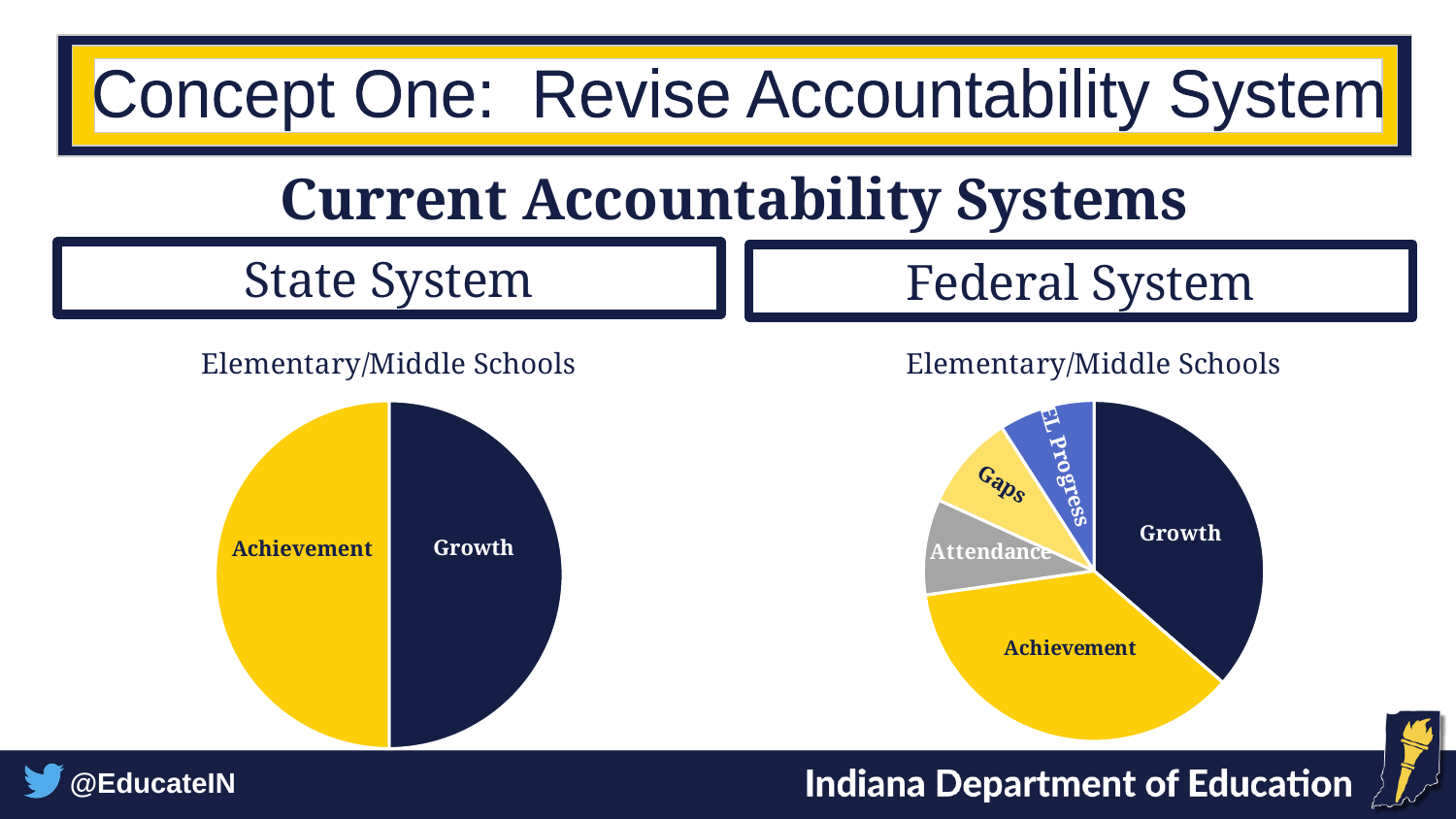
What colour is the Growth slice in the State System pie chart? Dark navy blue What are the two slices in the State System pie chart? Achievement and Growth In the Federal System pie chart, which slice is larger, Achievement or Gaps? Achievement What kind of chart is used for the Federal System Elementary/Middle Schools? Pie chart How many slices does the Federal System pie chart have? 5 What kind of chart is used for the State System Elementary/Middle Schools? Pie chart In the Federal System pie chart, which slice is larger, Growth or Attendance? Growth How many slices does the State System pie chart have? 2